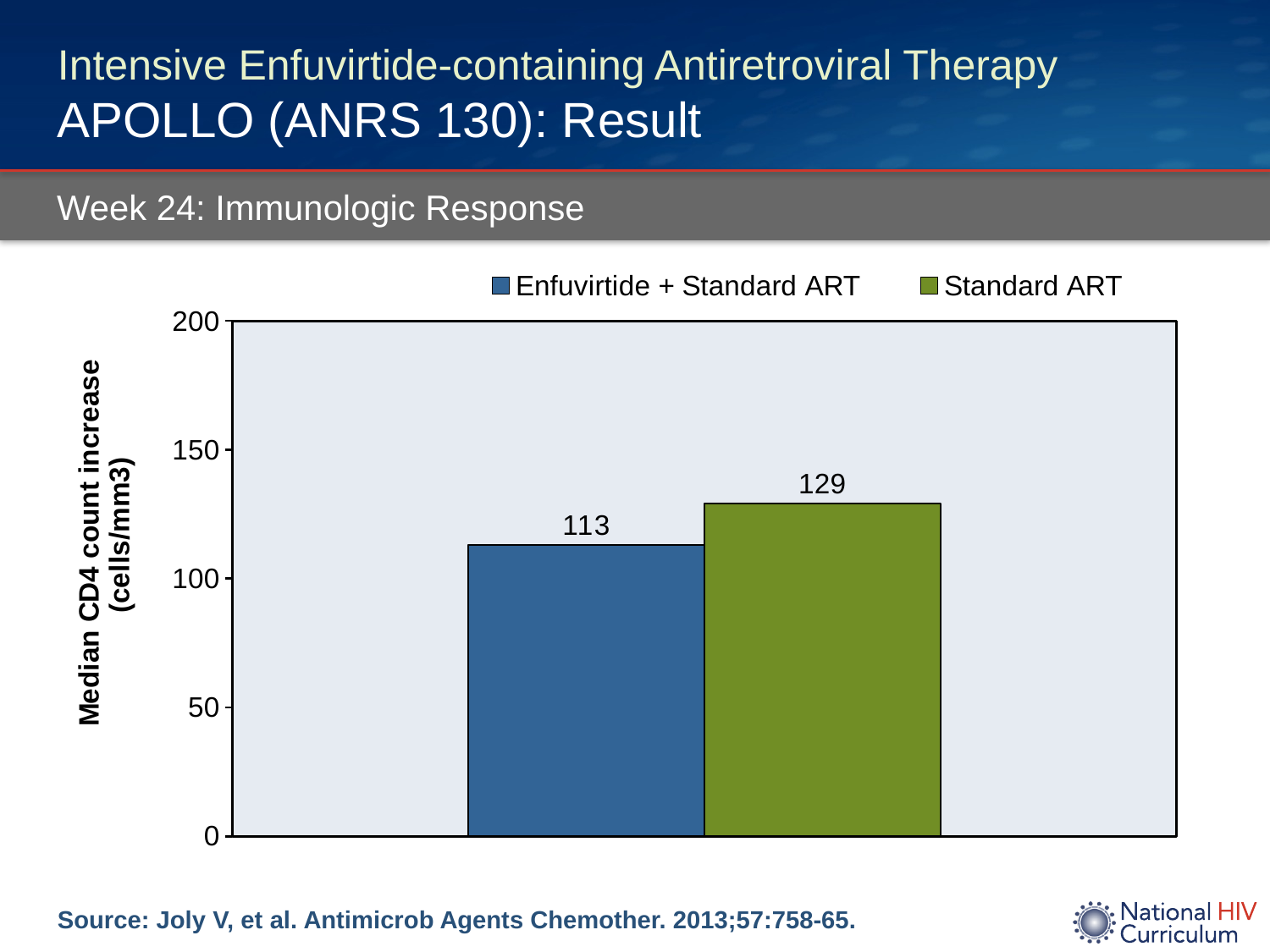
Is the value for Standard ART greater or less than 100? greater What is the difference in median CD4 count increase between Standard ART and Enfuvirtide + Standard ART? 16 What kind of chart is shown on the slide? Bar chart How many series does the legend list? 2 How many bars are plotted in the chart? 2 What is the median CD4 count increase for Standard ART? 129 Which group has the lower median CD4 count increase? Enfuvirtide + Standard ART What is the label of the y axis? Median CD4 count increase (cells/mm3) What is the median CD4 count increase for Enfuvirtide + Standard ART? 113 Which group has the higher median CD4 count increase? Standard ART Is the median CD4 count increase larger for Enfuvirtide + Standard ART or for Standard ART? Standard ART Is the value for Enfuvirtide + Standard ART greater or less than 150? less